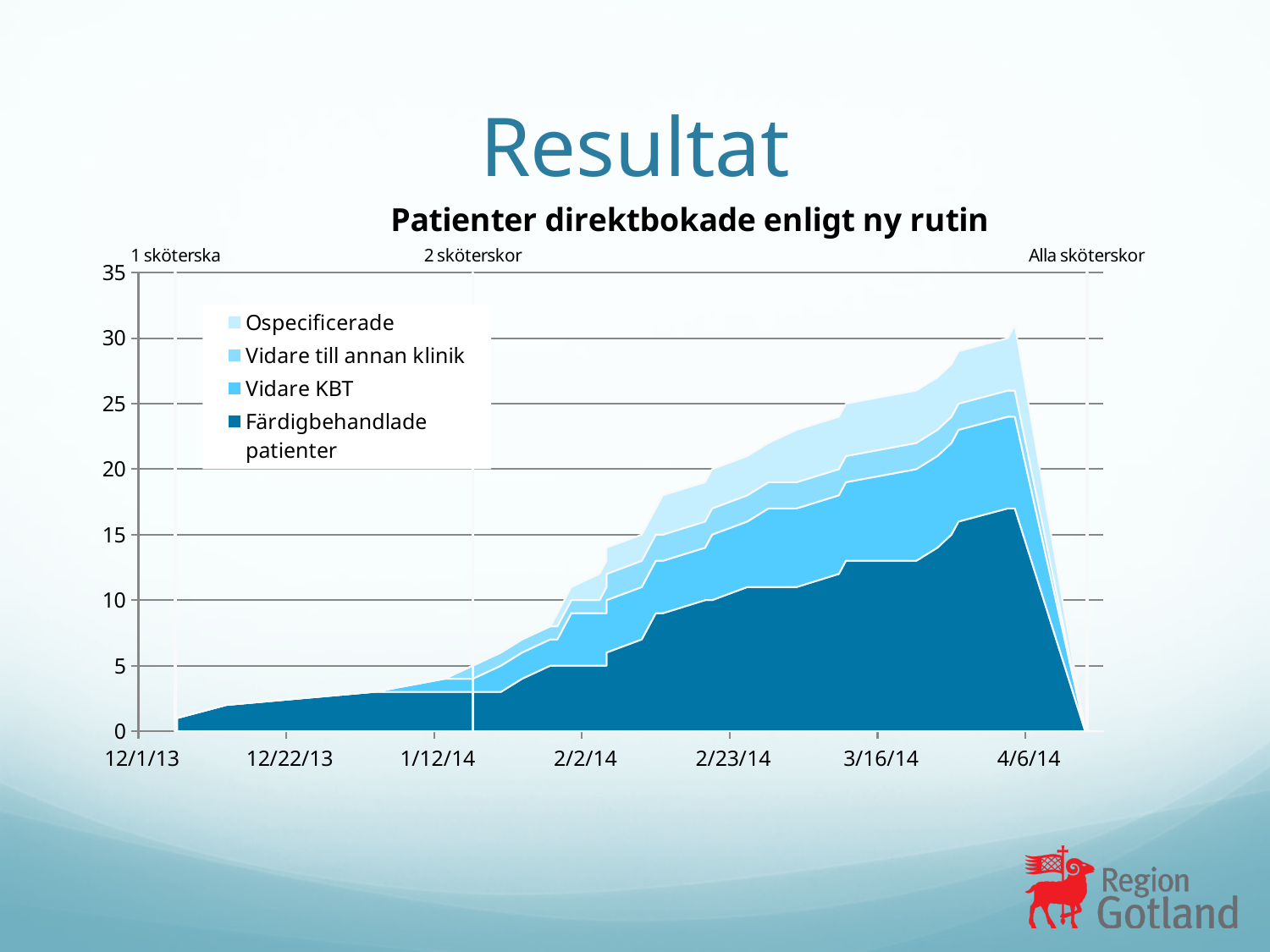
How many series does the legend list? 4 Is the value for Färdigbehandlade patienter at 3/16/14 greater or less than 10? greater Does the total stacked value generally rise or fall from 12/1/13 to 4/6/14? rise How many date labels are shown on the x axis? 7 Which series is shown in the darkest blue at the bottom of the stack? Färdigbehandlade patienter Is the total stacked value at 3/16/14 greater or less than 20? greater What is the highest value shown on the y axis? 35 Is the total stacked value at 1/12/14 greater or less than 5? less What kind of chart is shown on the slide? Stacked area chart What is the title of the chart? Patienter direktbokade enligt ny rutin